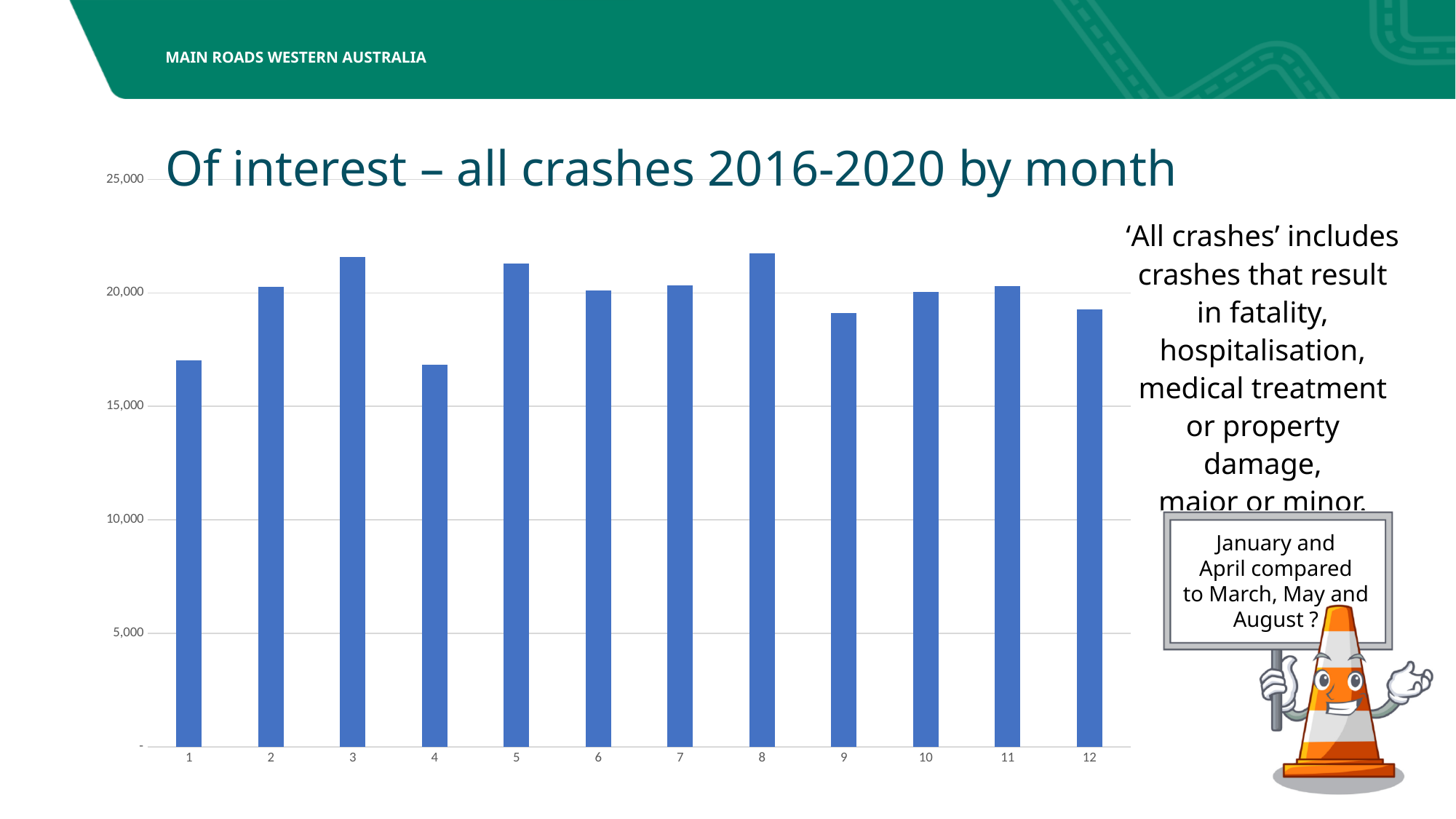
Is the value for month 12 greater or less than 15,000? greater What kind of chart is shown on the slide? bar chart Is the value for month 9 greater or less than 20,000? less Which has the larger value, month 4 or month 8? month 8 Which has the larger value, month 9 or month 5? month 5 How many months (categories) are plotted on the x axis? 12 Is the value for month 8 greater or less than 20,000? greater What is the title of the chart? Of interest – all crashes 2016-2020 by month Which has the larger value, month 1 or month 3? month 3